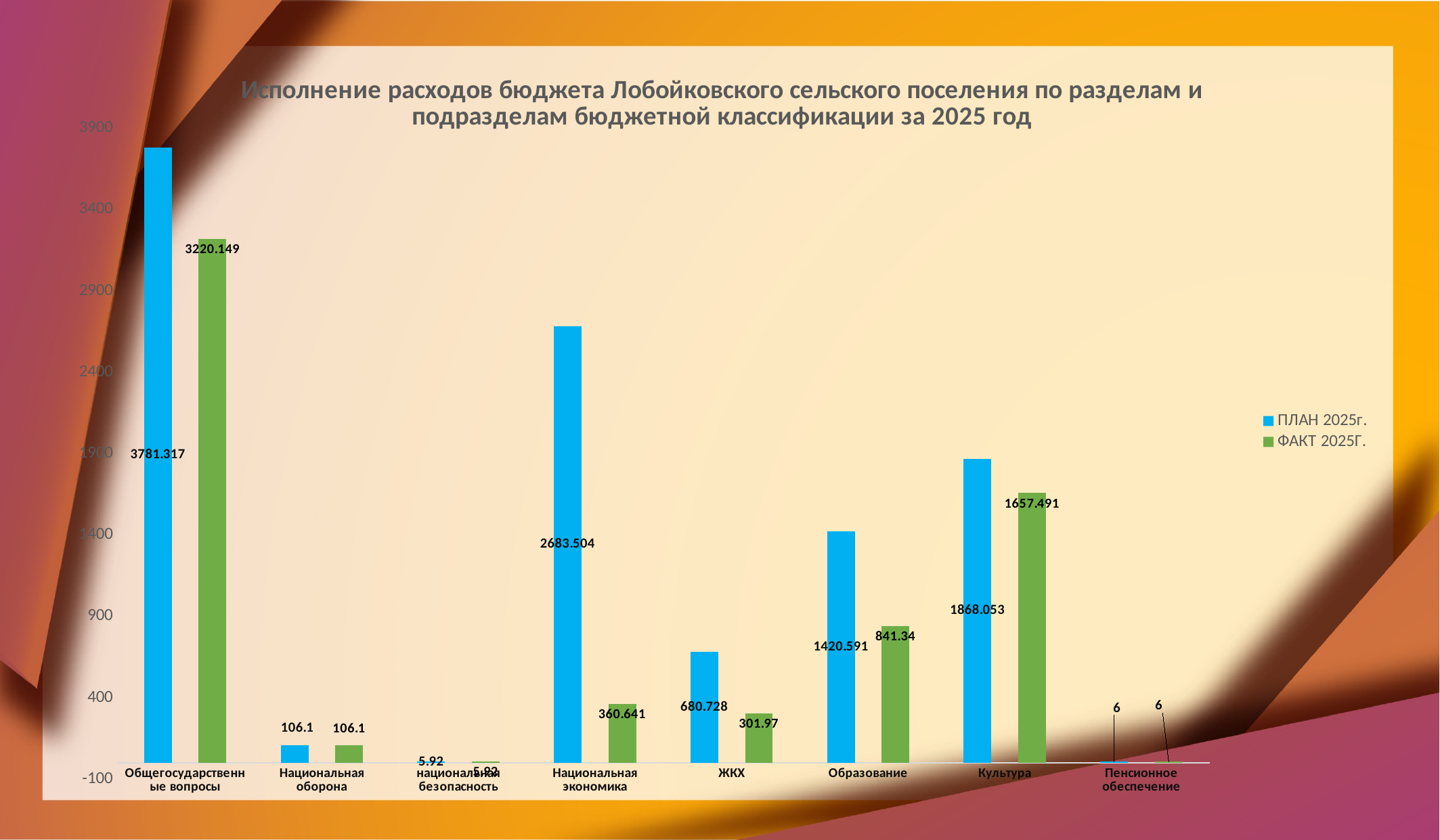
Which category has the highest ПЛАН 2025г. value? Общегосударственные вопросы What type of chart is shown on the slide? bar chart What is the difference between the ПЛАН 2025г. and ФАКТ 2025Г. values for Образование? 579.251 How many series does the legend list? 2 Which category has the lowest ФАКТ 2025Г. value? национальная безопасность What is the ФАКТ 2025Г. value for Национальная экономика? 360.641 Which is larger for ЖКХ: the ПЛАН 2025г. value or the ФАКТ 2025Г. value? ПЛАН 2025г. What is the difference between the ПЛАН 2025г. and ФАКТ 2025Г. values for Национальная экономика? 2322.863 What is the ФАКТ 2025Г. value for Культура? 1657.491 What is the ПЛАН 2025г. value for Общегосударственные вопросы? 3781.317 How many categories are shown on the x axis? 8 Which series is shown in green in the legend? ФАКТ 2025Г.